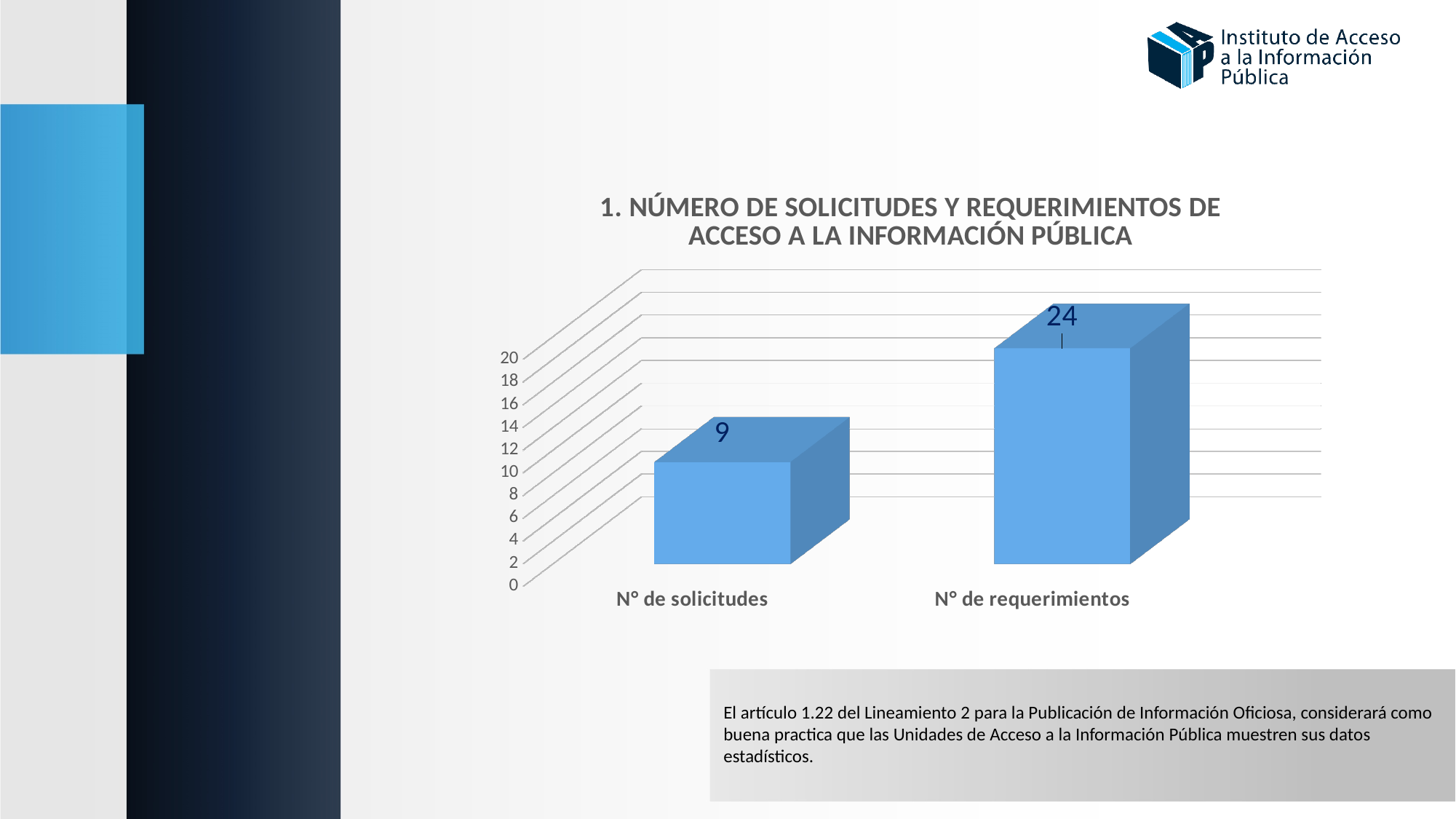
What is the highest value shown on the vertical axis? 20 Which is larger, N° de solicitudes or N° de requerimientos? N° de requerimientos Which category has the lowest value? N° de solicitudes Is the value for N° de solicitudes greater or less than 10? less What is the title of the chart? 1. NÚMERO DE SOLICITUDES Y REQUERIMIENTOS DE ACCESO A LA INFORMACIÓN PÚBLICA How many categories are shown in the chart? 2 Which category has the highest value? N° de requerimientos What is the value for N° de requerimientos? 24 What is the difference between N° de requerimientos and N° de solicitudes? 15 What kind of chart is shown on the slide? Bar chart What is the value for N° de solicitudes? 9